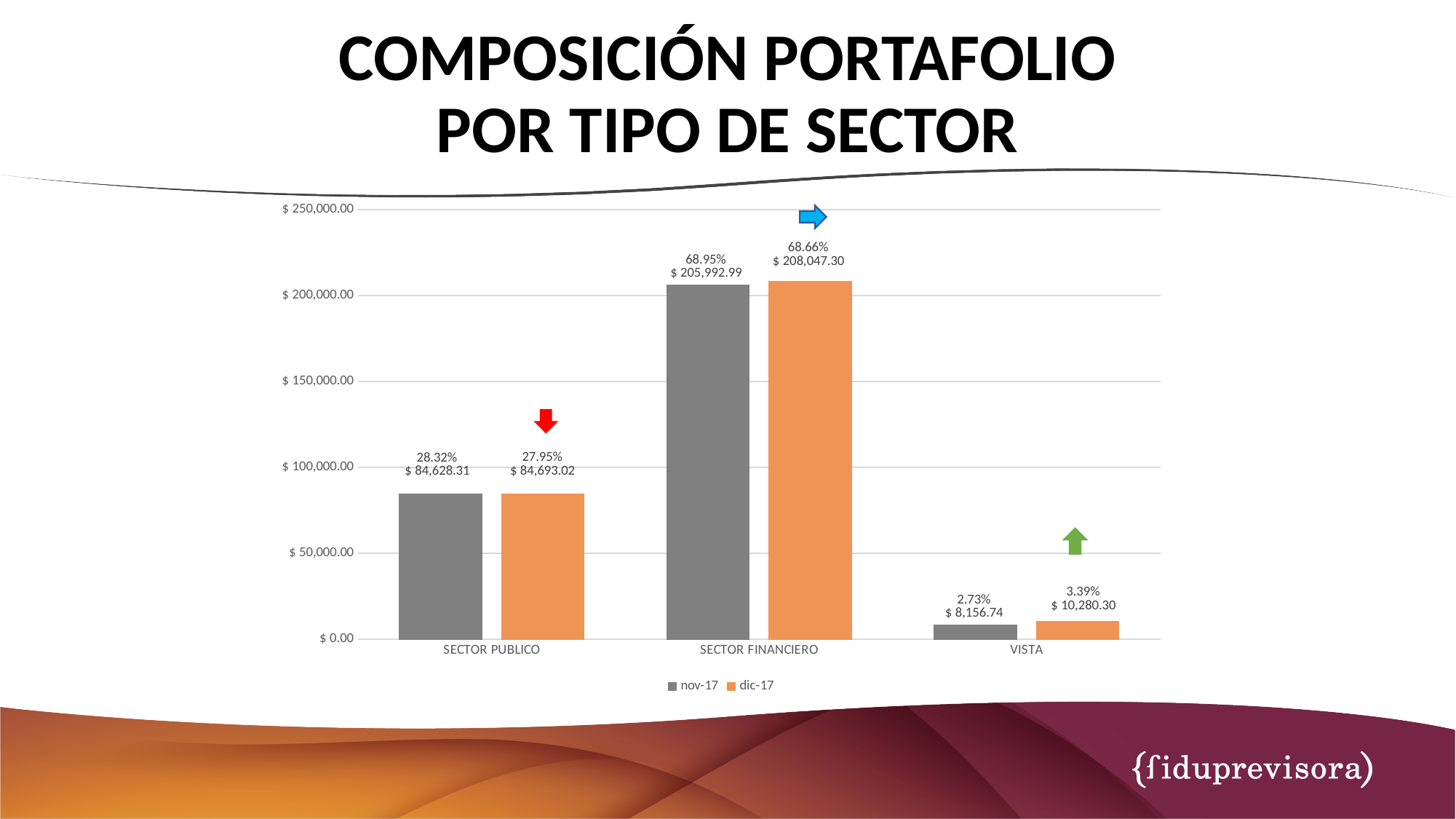
Which category has the highest value in the dic-17 series? SECTOR FINANCIERO What is the value for SECTOR FINANCIERO in the dic-17 series? $ 208,047.30 Is the nov-17 value for SECTOR PUBLICO greater or less than $ 100,000.00? less How many series does the legend list? 2 What percentage is shown for VISTA in the dic-17 series? 3.39% What percentage is shown for SECTOR PUBLICO in the nov-17 series? 28.32% How many categories are shown on the x axis? 3 Which category has the lowest value in the nov-17 series? VISTA Which is larger for SECTOR FINANCIERO, the nov-17 value or the dic-17 value? dic-17 What is the value for VISTA in the nov-17 series? $ 8,156.74 What kind of chart is shown on the slide? bar chart What is the difference between the dic-17 and nov-17 values for VISTA? $ 2,123.56